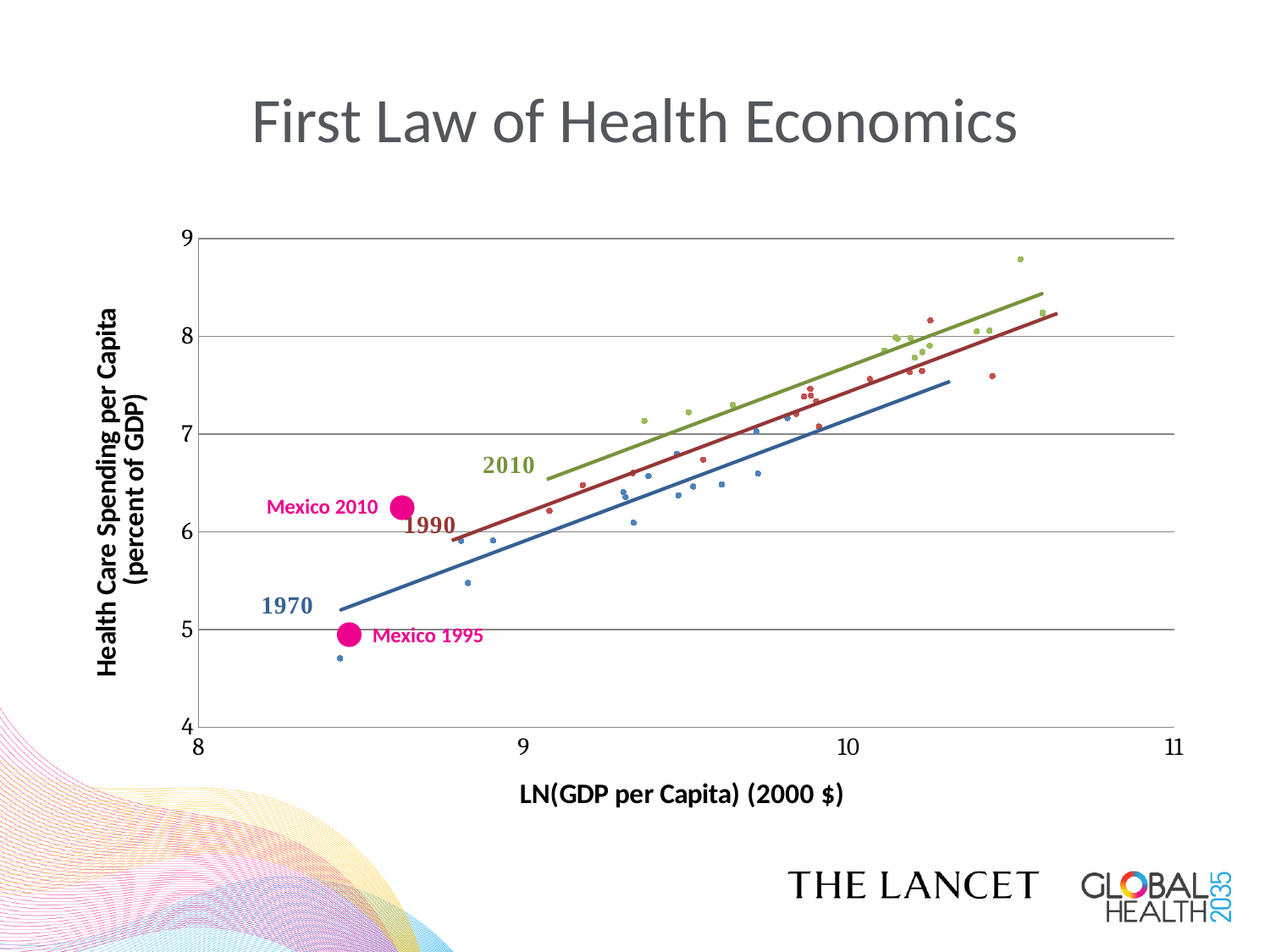
What kind of chart is shown on the slide? scatter chart Is the health care spending value for Mexico 1995 greater or less than 6? less How many year trend lines are drawn on the chart? 3 What is the title of the chart on the slide? First Law of Health Economics Which point has the higher health care spending value, Mexico 2010 or Mexico 1995? Mexico 2010 Do the trend lines rise or fall as LN(GDP per Capita) increases? rise Which year's trend line sits lowest on the chart? 1970 Is the health care spending value for Mexico 2010 greater or less than 7? less Is the health care spending value for Mexico 2010 greater or less than 6? greater What is the label of the x axis? LN(GDP per Capita) (2000 $) Which year's trend line sits highest on the chart? 2010